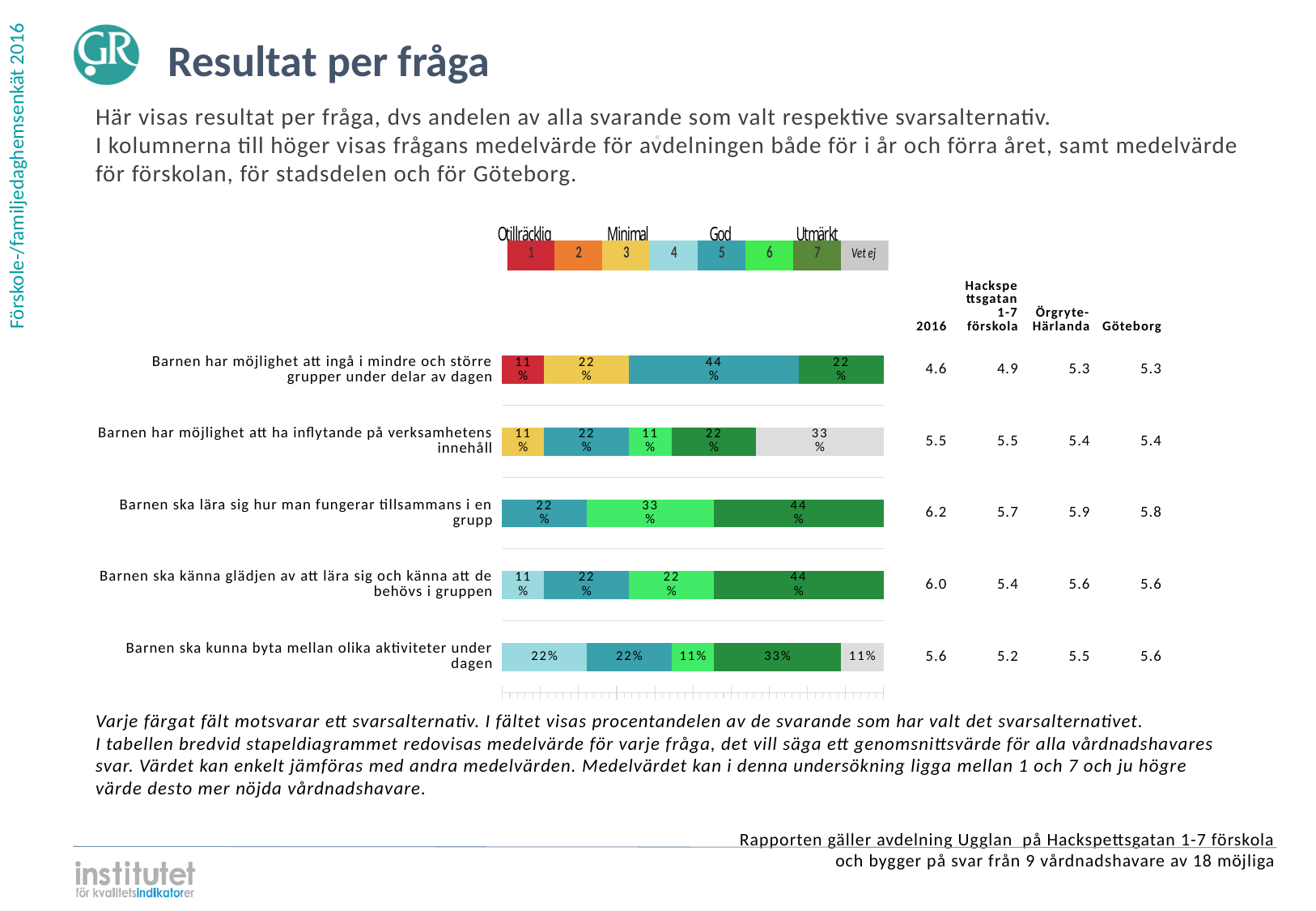
Which question has the lowest 2016 mean value? Barnen har möjlighet att ingå i mindre och större grupper under delar av dagen What is the difference between the highest and lowest 2016 mean values? 1.6 How many questions (categories) are plotted in the bar chart? 5 What is the Göteborg mean value for "Barnen ska kunna byta mellan olika aktiviteter under dagen"? 5.6 Which question has the highest 2016 mean value? Barnen ska lära sig hur man fungerar tillsammans i en grupp How many answer options, including "Vet ej", does the legend above the chart show? 8 For "Barnen ska kunna byta mellan olika aktiviteter under dagen", which is larger: the 2016 mean or the Hackspettsgatan 1-7 förskola mean? 2016 What percentage of respondents answered "Vet ej" for "Barnen har möjlighet att ha inflytande på verksamhetens innehåll"? 33% What kind of chart is shown on the slide? Stacked bar chart What percentage of respondents chose answer 7 (Utmärkt) for "Barnen ska lära sig hur man fungerar tillsammans i en grupp"? 44% What percentage of respondents chose answer 1 (Otillräcklig) for "Barnen har möjlighet att ingå i mindre och större grupper under delar av dagen"? 11% What is the 2016 mean value for "Barnen ska känna glädjen av att lära sig och känna att de behövs i gruppen"? 6.0